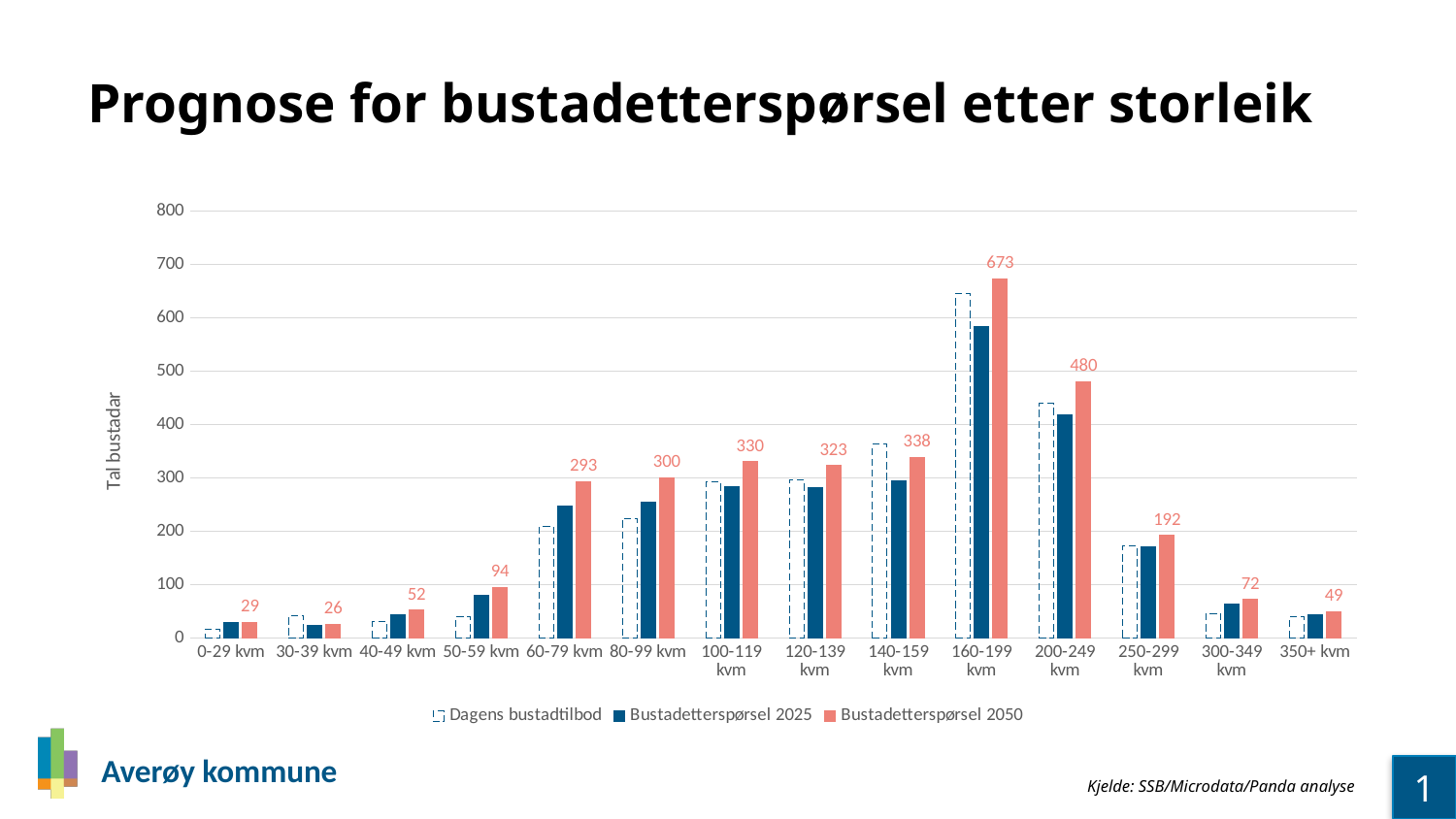
How many series does the legend list? 3 Is the Dagens bustadtilbod value for 140-159 kvm greater or less than 300? greater Which size category has the lowest Bustadetterspørsel 2050 value? 30-39 kvm What is the difference between the Bustadetterspørsel 2050 values for 160-199 kvm and 200-249 kvm? 193 Is the Bustadetterspørsel 2025 value for 160-199 kvm greater or less than 500? greater What is the Bustadetterspørsel 2050 value for 250-299 kvm? 192 What type of chart is shown on the slide? Bar chart Which size category has the highest Bustadetterspørsel 2050 value? 160-199 kvm What is the Bustadetterspørsel 2050 value for 60-79 kvm? 293 Which is larger for Bustadetterspørsel 2050: 100-119 kvm or 120-139 kvm? 100-119 kvm What is the Bustadetterspørsel 2050 value for 160-199 kvm? 673 How many size categories are shown on the x axis? 14